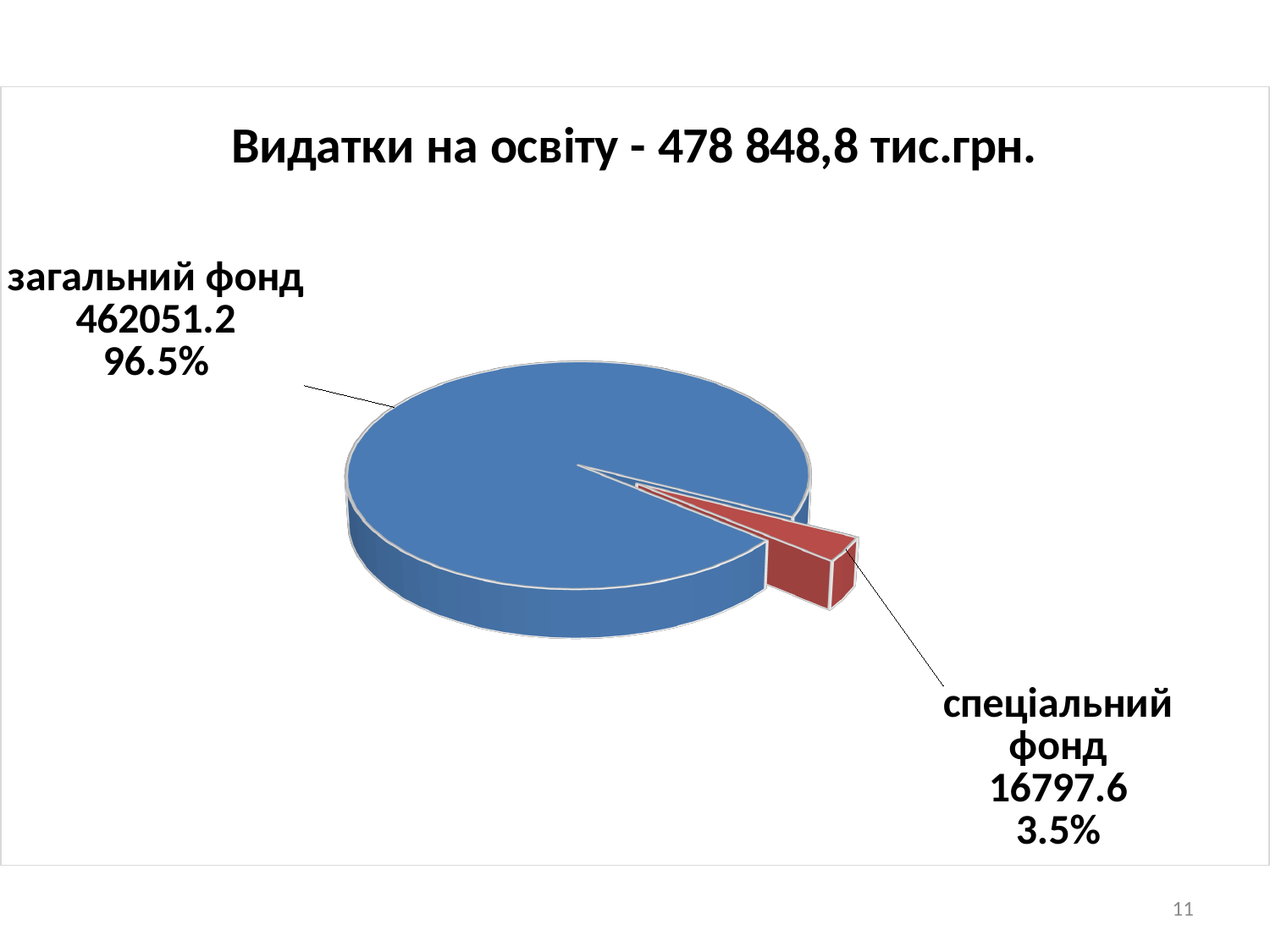
What is the value for спеціальний фонд? 16797.6 What is the title of the chart? Видатки на освіту - 478 848,8 тис.грн. What is the difference between the values for загальний фонд and спеціальний фонд? 445253.6 Which slice is the smallest? спеціальний фонд What share of the pie does загальний фонд represent? 96.5% Which is larger, загальний фонд or спеціальний фонд? загальний фонд How many slices does the pie chart have? 2 Which slice is the largest? загальний фонд What colour is the слice for спеціальний фонд? red What share of the pie does спеціальний фонд represent? 3.5% What type of chart is shown on the slide? pie chart What is the value for загальний фонд? 462051.2